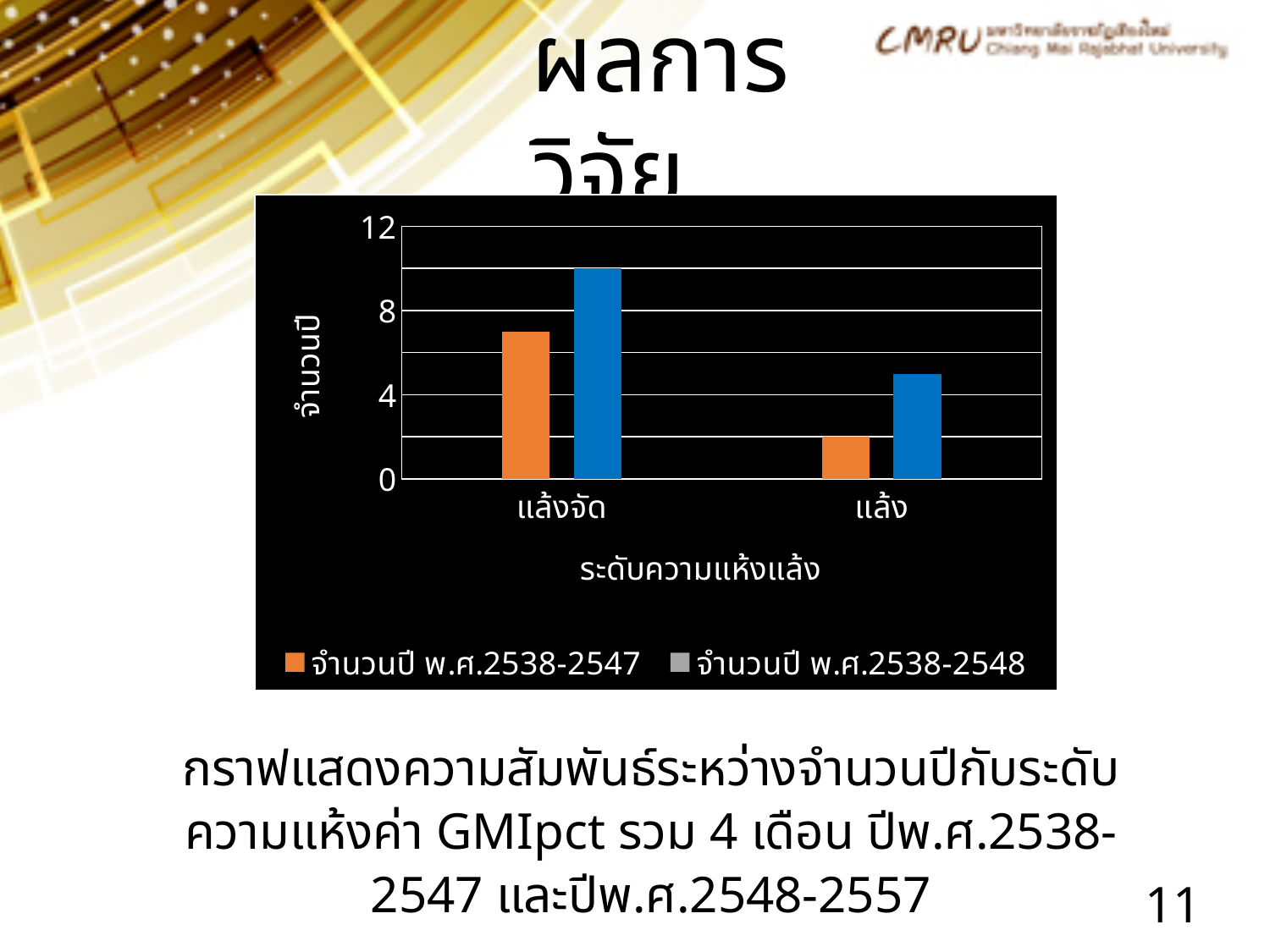
Which category has the higher value in the series จำนวนปี พ.ศ.2538-2548, แล้งจัด or แล้ง? แล้งจัด Which category has the lowest value in the series จำนวนปี พ.ศ.2538-2547? แล้ง What kind of chart is shown on the slide? bar chart Is the value for แล้งจัด in the series จำนวนปี พ.ศ.2538-2547 greater or less than 8? less Is the value for แล้งจัด in the series จำนวนปี พ.ศ.2538-2547 greater or less than 4? greater How many categories are shown on the x axis of the chart? 2 Is the value for แล้ง in the series จำนวนปี พ.ศ.2538-2547 greater or less than 4? less What is the label of the x axis of the chart? ระดับความแห้งแล้ง How many series does the chart's legend list? 2 What is the label of the y axis of the chart? จำนวนปี